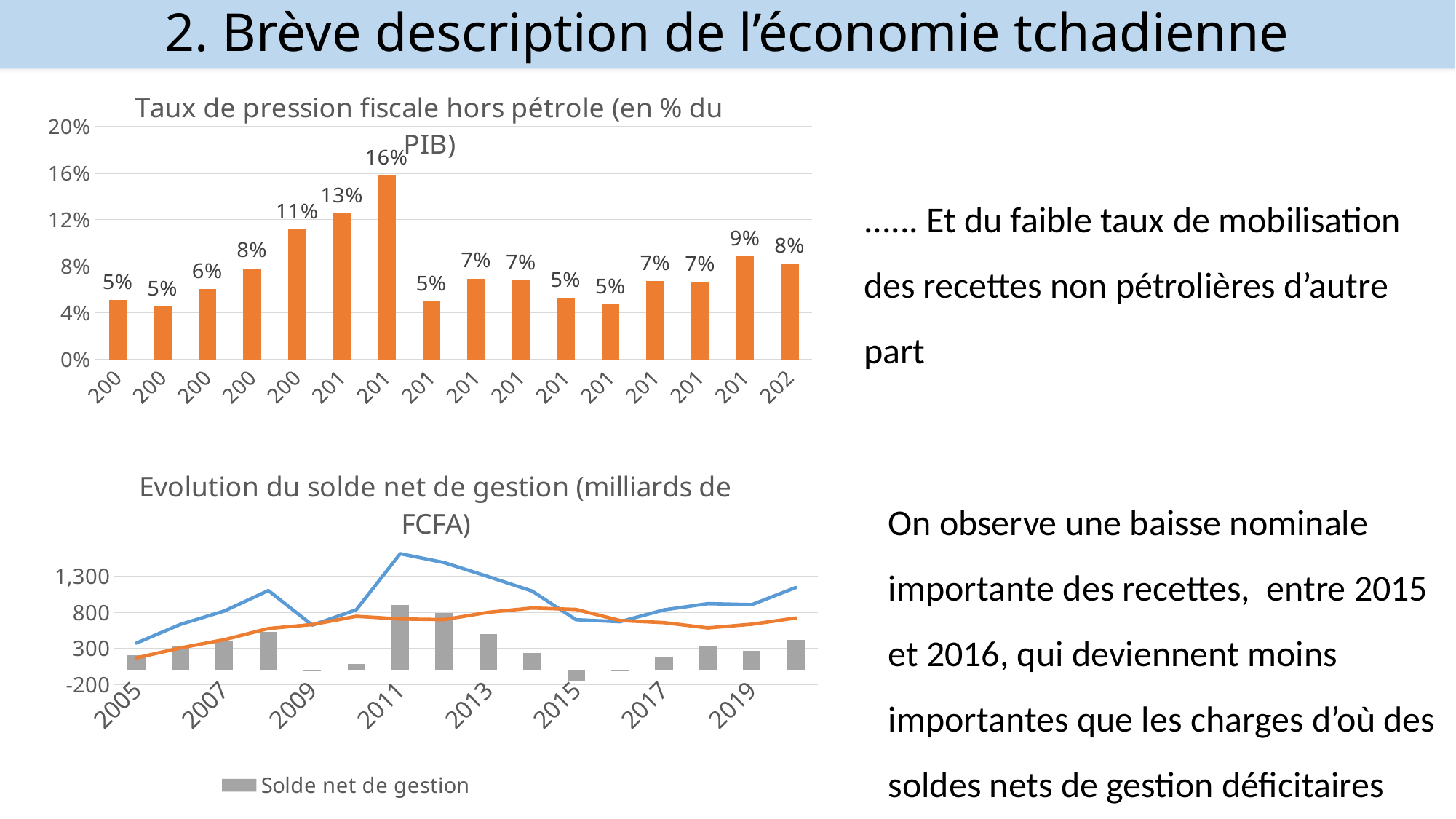
In the chart 'Taux de pression fiscale hors pétrole (en % du PIB)', what is the value of the first (leftmost) bar? 5% In the chart 'Taux de pression fiscale hors pétrole (en % du PIB)', what is the value of the last (rightmost) bar? 8% In the chart 'Taux de pression fiscale hors pétrole (en % du PIB)', how many bars are plotted? 16 In the chart 'Evolution du solde net de gestion (milliards de FCFA)', is the blue line at 2011 greater or less than 1,300? greater In the chart 'Taux de pression fiscale hors pétrole (en % du PIB)', what is the highest value shown? 16% In the chart 'Evolution du solde net de gestion (milliards de FCFA)', is the bar for 2015 greater or less than 0? less In the chart 'Evolution du solde net de gestion (milliards de FCFA)', which is larger: the bar for 2011 or the bar for 2009? 2011 In the chart 'Taux de pression fiscale hors pétrole (en % du PIB)', what is the difference between the highest bar (16%) and the lowest bar (5%)? 11 percentage points In the chart 'Evolution du solde net de gestion (milliards de FCFA)', what is the single entry shown in the legend? Solde net de gestion What kind of chart is 'Taux de pression fiscale hors pétrole (en % du PIB)'? Bar chart In the chart 'Evolution du solde net de gestion (milliards de FCFA)', is the bar for 2008 greater or less than 300? greater In the chart 'Taux de pression fiscale hors pétrole (en % du PIB)', what colour are the bars? Orange